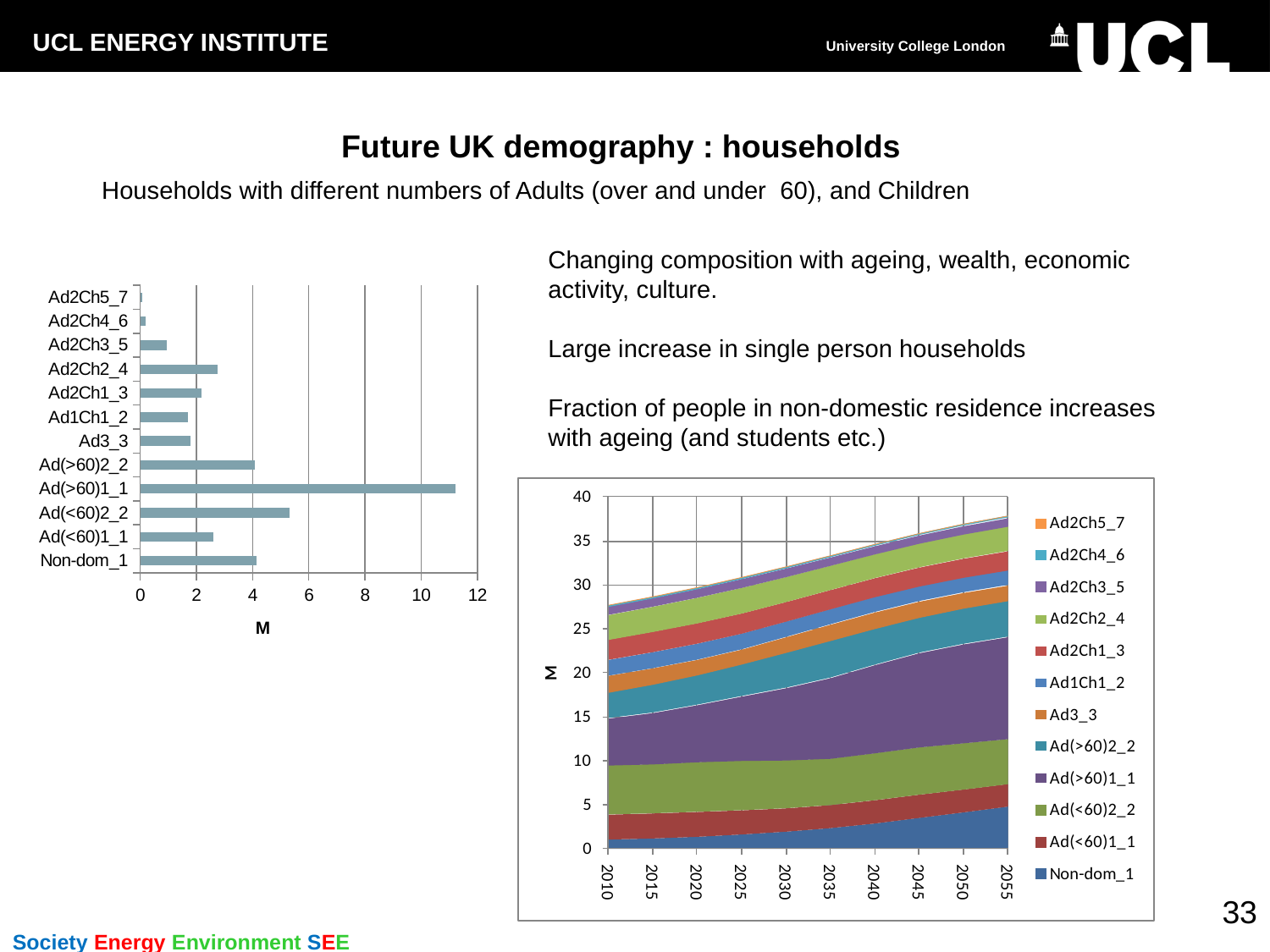
On the right-hand area chart, does the total of all series rise or fall from 2010 to 2055? rise On the left bar chart, is the value for Ad2Ch3_5 greater or less than 2? less On the left bar chart, which is larger, the value for Ad(>60)1_1 or the value for Ad(<60)2_2? Ad(>60)1_1 On the left bar chart, is the value for Ad(>60)1_1 greater or less than 10? greater What kind of chart is the chart on the left of the slide? bar chart On the left bar chart, is the value for Ad(<60)2_2 greater or less than 4? greater On the left bar chart, which category has the lowest value? Ad2Ch5_7 What kind of chart is the chart on the right of the slide? stacked area chart How many categories are shown on the left bar chart? 12 On the left bar chart, which is larger, the value for Ad2Ch2_4 or the value for Ad2Ch3_5? Ad2Ch2_4 On the left bar chart, which category has the highest value? Ad(>60)1_1 How many series does the legend of the right-hand area chart list? 12